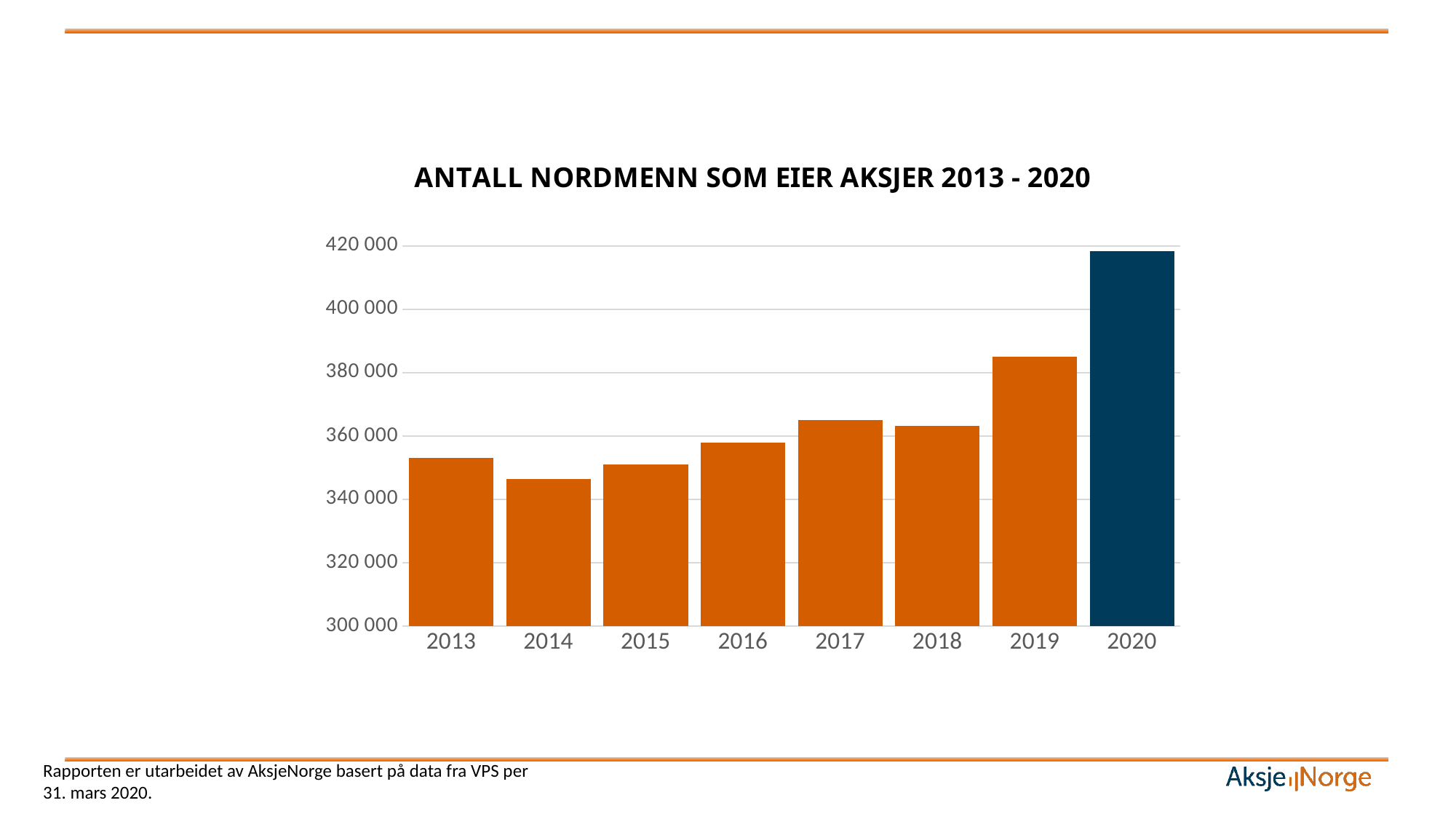
Which year's bar is shown in a different colour (dark blue) from the others? 2020 Is the value for 2019 greater or less than 380 000? greater Do the values generally rise or fall from 2014 to 2020? Rise Which year has the lowest value in the chart? 2014 Which year has the larger value, 2019 or 2018? 2019 Which year has the highest value in the chart? 2020 What kind of chart is shown on the slide? Bar chart How many years are shown on the x axis of the chart? 8 What is the title of the chart? ANTALL NORDMENN SOM EIER AKSJER 2013 - 2020 Is the value for 2014 greater or less than 340 000? greater Is the value for 2020 greater or less than 400 000? greater